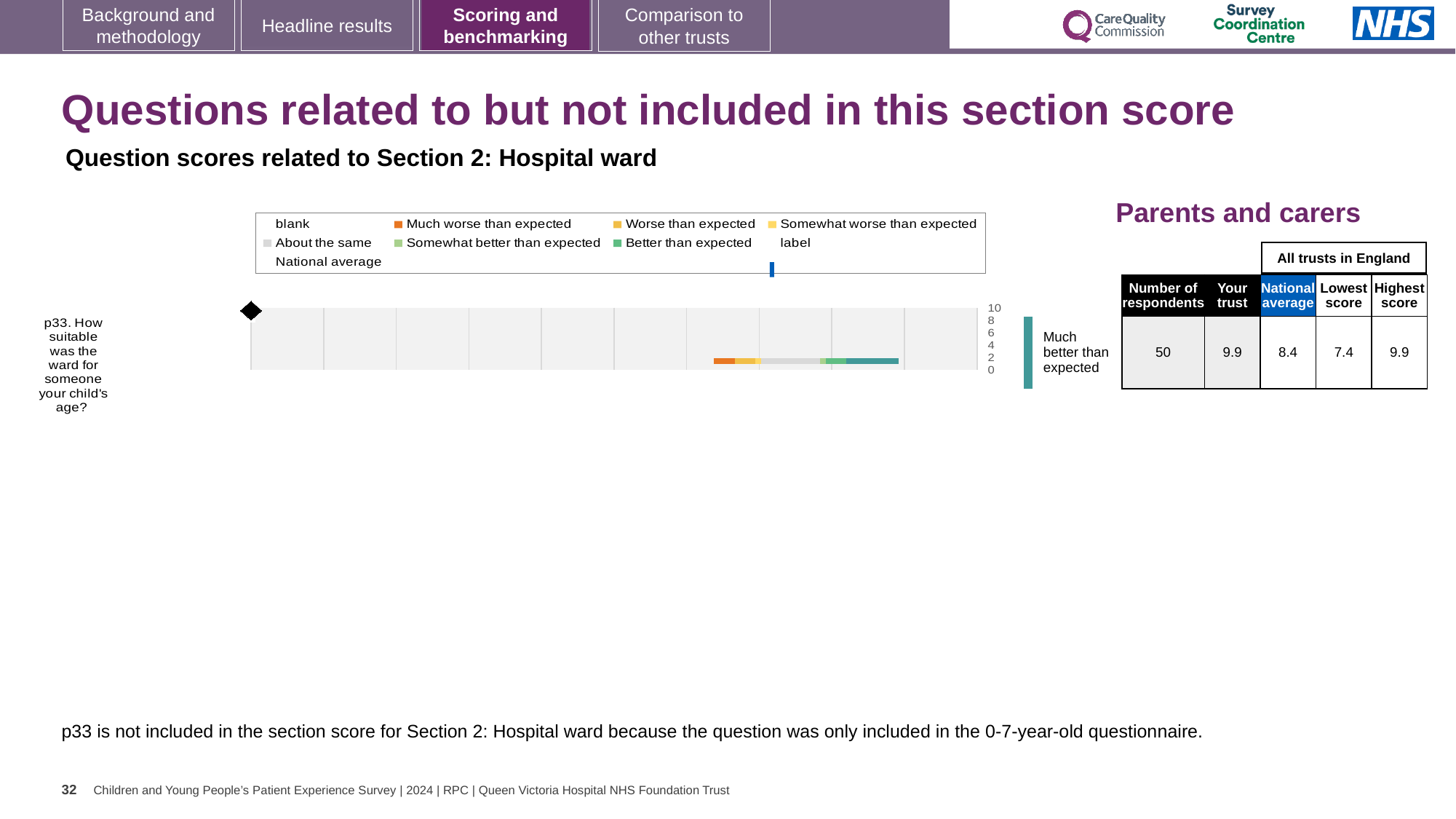
What is the lowest score among all trusts in England for p33? 7.4 Which is larger for p33: the 'Your trust' score or the national average? Your trust Which survey question is plotted in the chart? p33. How suitable was the ward for someone your child's age? What benchmark category label is shown to the right of the chart for p33? Much better than expected What is the highest score among all trusts in England for p33? 9.9 What is the difference between the 'Your trust' score and the national average for p33? 1.5 What kind of chart is shown on the slide for question p33? Bar chart How many questions are plotted in the chart on the slide? 1 What is the 'Your trust' score for p33 shown in the table next to the chart? 9.9 What is the national average score for p33 shown in the table next to the chart? 8.4 How many respondents answered question p33? 50 What is the difference between the highest and lowest scores among all trusts in England for p33? 2.5